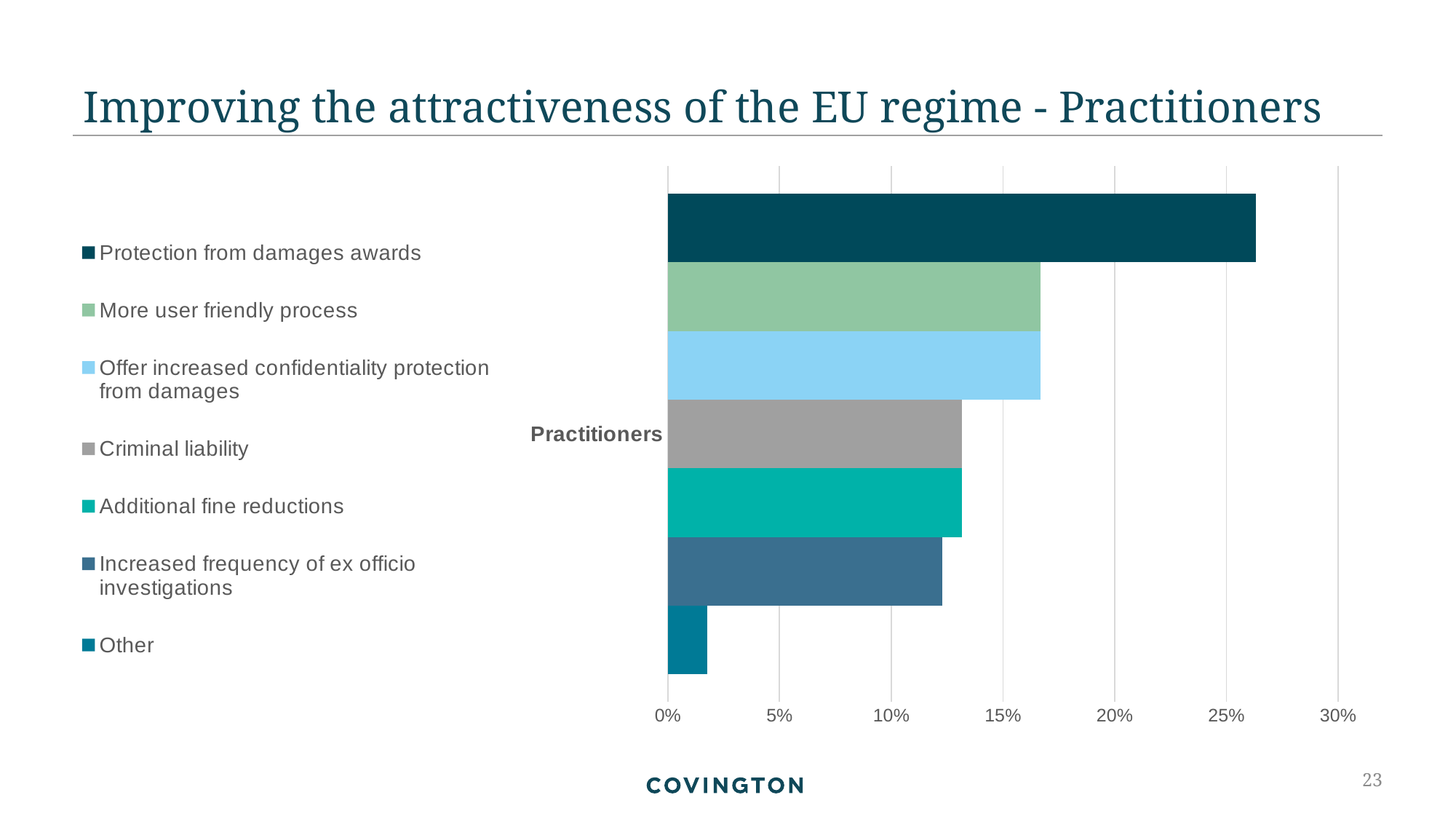
Is the value for Protection from damages awards greater or less than 25%? greater Which is larger, the value for Protection from damages awards or the value for Criminal liability? Protection from damages awards Which is larger, the value for Other or the value for Additional fine reductions? Additional fine reductions Which series has the highest value for Practitioners? Protection from damages awards Is the value for More user friendly process greater or less than 15%? greater How many series does the legend list? 7 What kind of chart is shown on the slide? bar chart Is the value for Increased frequency of ex officio investigations greater or less than 10%? greater What is the title of the slide containing the chart? Improving the attractiveness of the EU regime - Practitioners Which series has the lowest value for Practitioners? Other